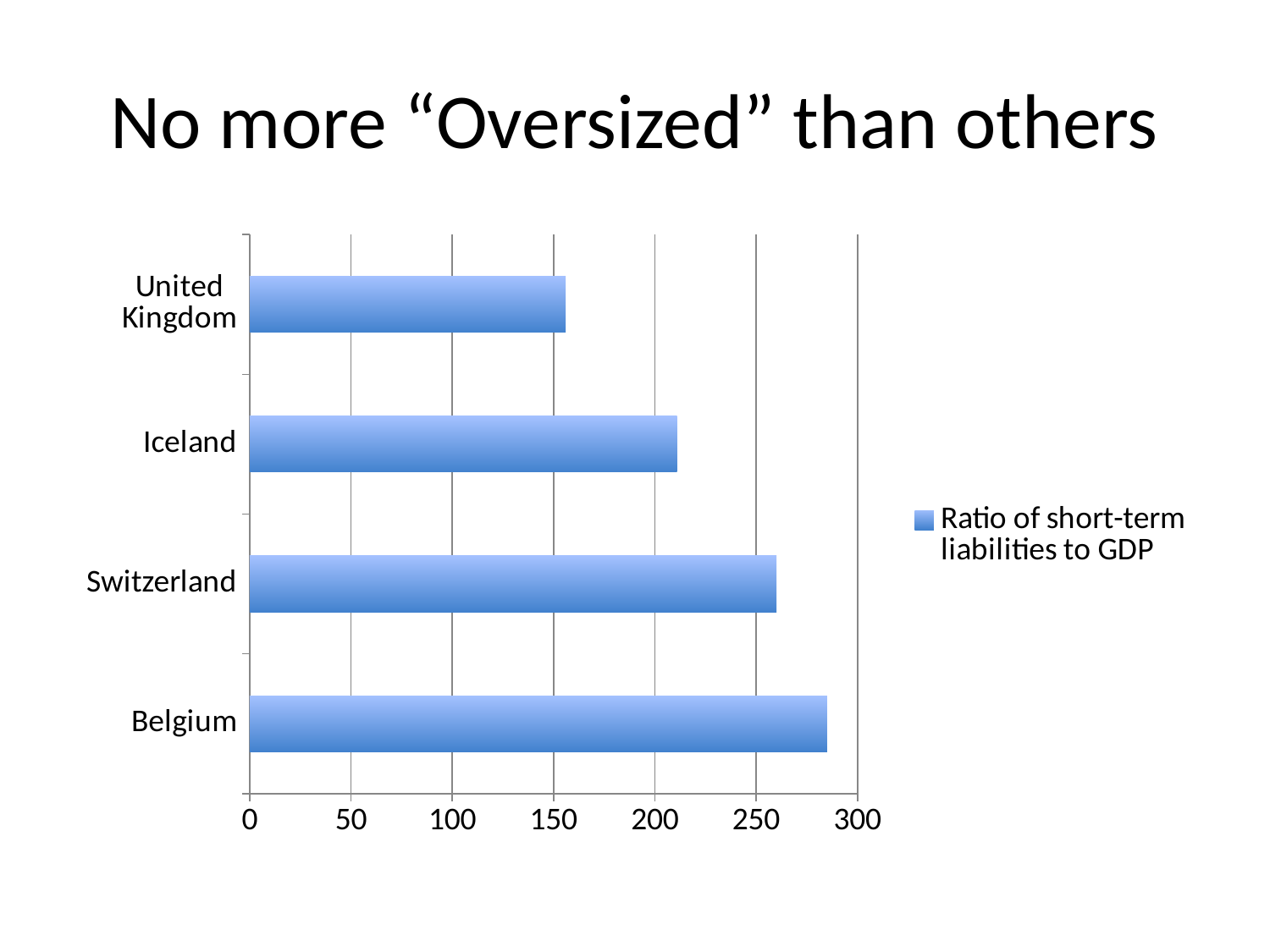
How many countries are shown in the chart? 4 Which country has the highest ratio of short-term liabilities to GDP? Belgium Is the value for Belgium greater or less than 300? less Is the value for the United Kingdom greater or less than 200? less Is the value for Switzerland greater or less than 250? greater Which has a larger ratio of short-term liabilities to GDP, Iceland or Switzerland? Switzerland Which country has the lowest ratio of short-term liabilities to GDP? United Kingdom How many series does the legend list? 1 What is the series name shown in the legend? Ratio of short-term liabilities to GDP What kind of chart is shown on the slide? bar chart